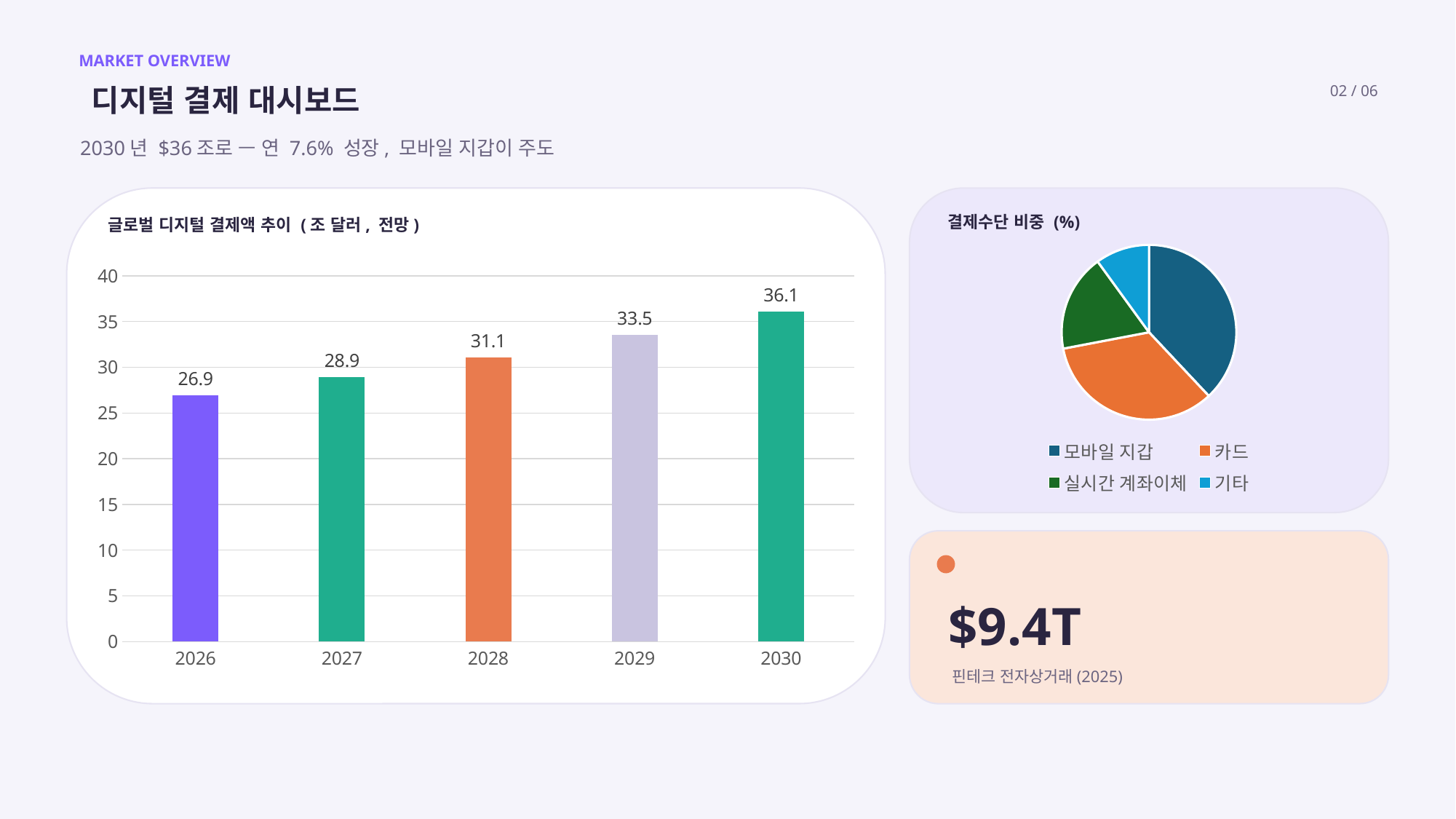
In the bar chart titled 글로벌 디지털 결제액 추이, what is the value for 2028? 31.1 In the bar chart titled 글로벌 디지털 결제액 추이, what is the value for 2030? 36.1 In the pie chart titled 결제수단 비중 (%), which category has the smallest slice? 기타 In the bar chart titled 글로벌 디지털 결제액 추이, which year has the lowest value? 2026 What kind of chart is the one titled 글로벌 디지털 결제액 추이? bar chart In the bar chart titled 글로벌 디지털 결제액 추이, what is the difference between the values for 2030 and 2026? 9.2 How many entries does the legend of the pie chart titled 결제수단 비중 (%) list? 4 In the bar chart titled 글로벌 디지털 결제액 추이, which is larger, the value for 2027 or the value for 2029? 2029 What kind of chart is the one titled 결제수단 비중 (%)? pie chart In the bar chart titled 글로벌 디지털 결제액 추이, do the values rise or fall from 2026 to 2030? rise In the bar chart titled 글로벌 디지털 결제액 추이, how many years are shown on the x axis? 5 In the bar chart titled 글로벌 디지털 결제액 추이, which year has the highest value? 2030